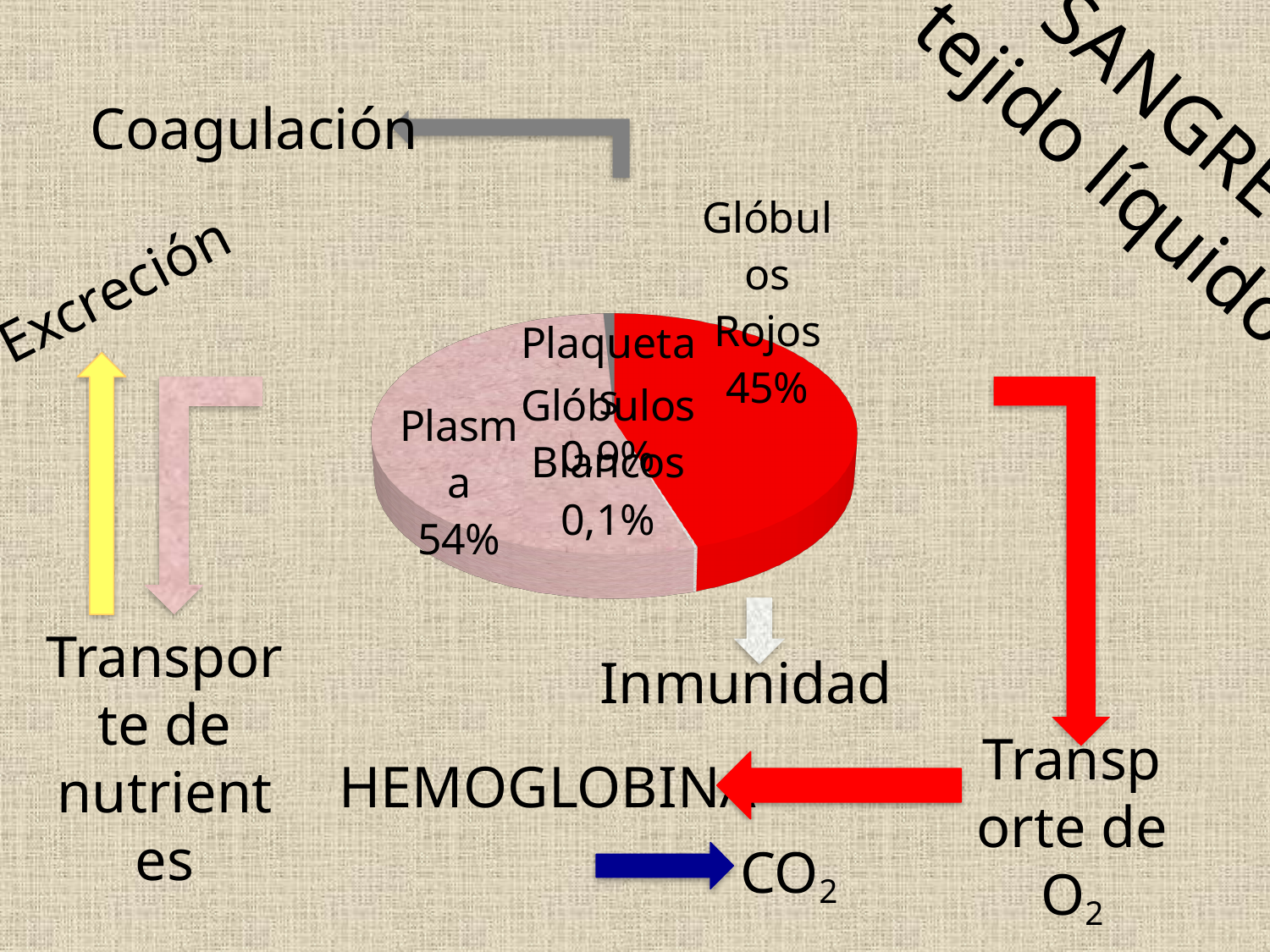
What percentage does the pie chart show for Plasma? 54% How many categories are shown in the pie chart? 4 What is the difference in percentage points between Plasma and Glóbulos Rojos? 9 Which category has the largest slice of the pie chart? Plasma What kind of chart is shown on the slide? pie chart What percentage does the pie chart show for Glóbulos Rojos? 45% What colour is the Glóbulos Rojos slice of the pie chart? red Which category has the smallest slice of the pie chart? Glóbulos Blancos Which is larger in the pie chart, Plasma or Glóbulos Rojos? Plasma What share of the pie does Glóbulos Rojos represent? 45% What percentage does the pie chart show for Glóbulos Blancos? 0,1%